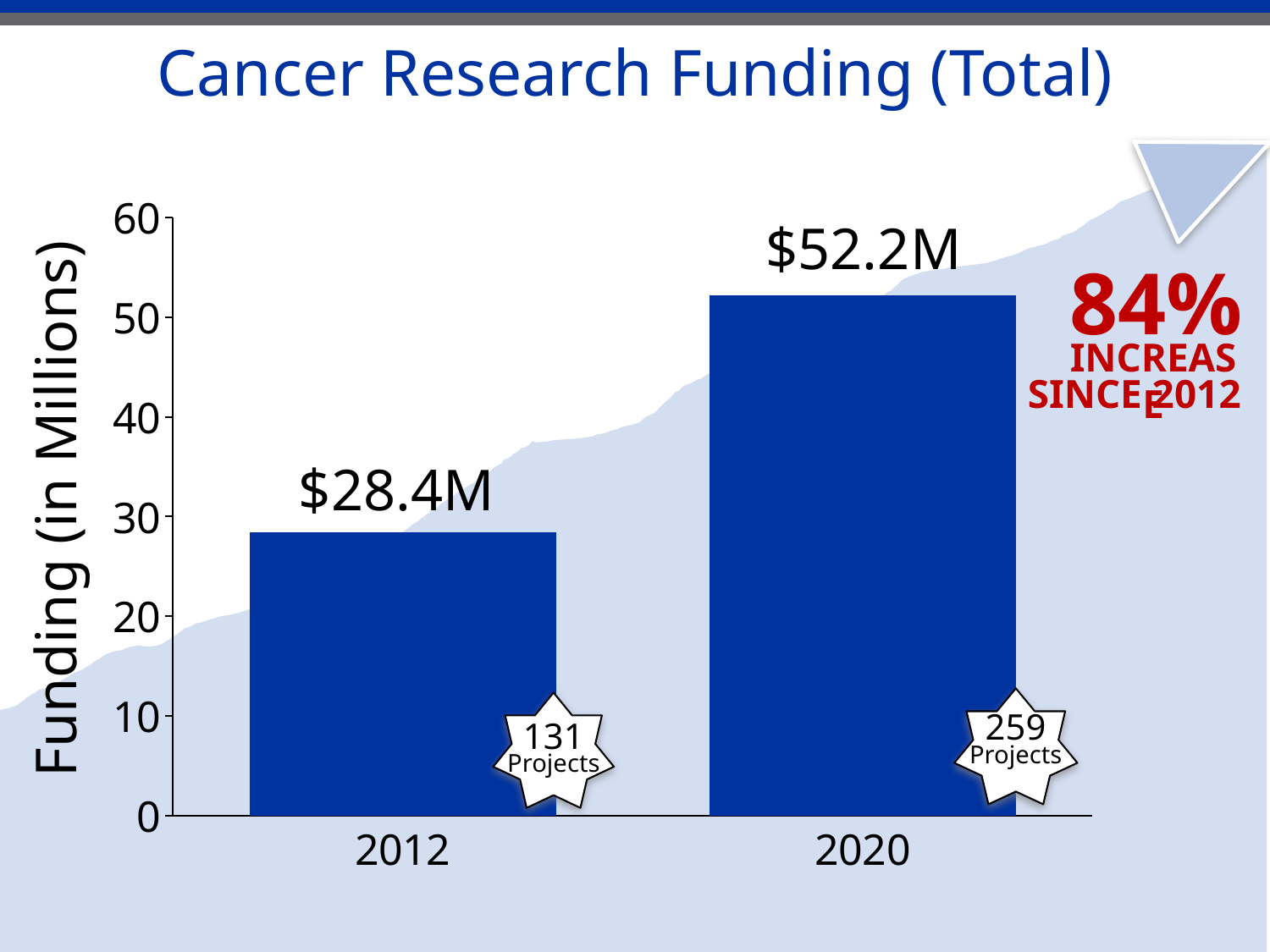
What is the difference in funding between 2020 and 2012? $23.8M Is the funding for 2020 greater or less than 50? greater What is the label of the y axis? Funding (in Millions) What kind of chart is shown? bar chart Does funding rise or fall from 2012 to 2020? rise How many years are shown on the x axis? 2 Which year has the lower funding? 2012 What is the funding value for 2020? $52.2M What is the funding value for 2012? $28.4M Which year has the higher funding? 2020 What is the title of the chart? Cancer Research Funding (Total) Is the funding for 2012 greater or less than 30? less